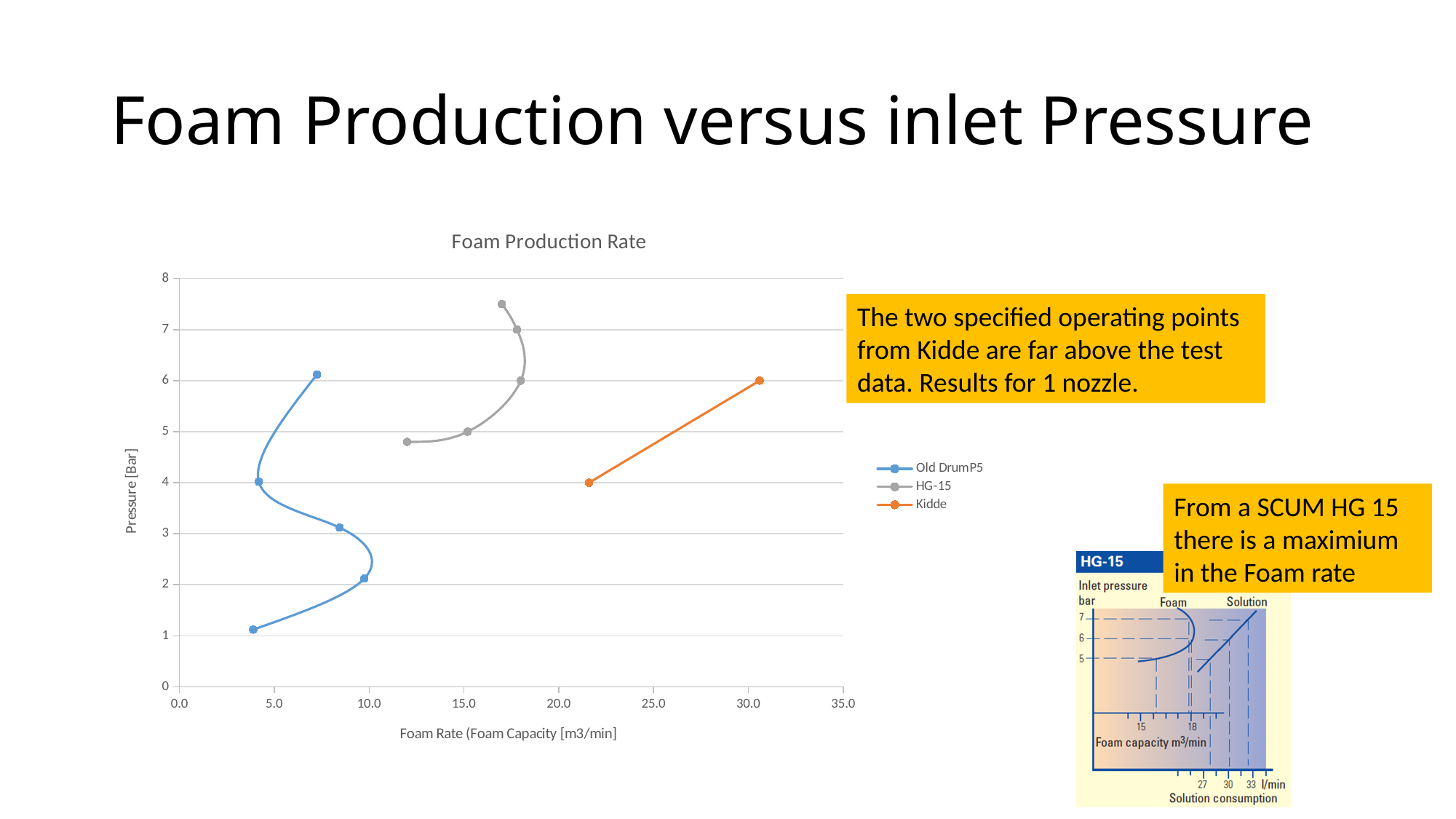
What is the pressure of the upper Kidde operating point? 6 What is the label of the vertical axis of the Foam Production Rate chart? Pressure [Bar] Is the foam rate of the Old DrumP5 point at about 4 bar greater or less than 5.0? less Which series reaches the highest foam rate on the chart? Kidde Is the foam rate of the Kidde point at 6 bar greater or less than 25.0? greater What are the three series named in the legend of the Foam Production Rate chart? Old DrumP5, HG-15, Kidde How many series does the legend of the Foam Production Rate chart list? 3 What kind of chart is shown on the slide? Scatter chart with smoothed lines How many data points are plotted for the HG-15 series? 5 What is the pressure of the lower Kidde operating point? 4 How many data points are plotted for the Old DrumP5 series? 5 How many data points are plotted for the Kidde series? 2